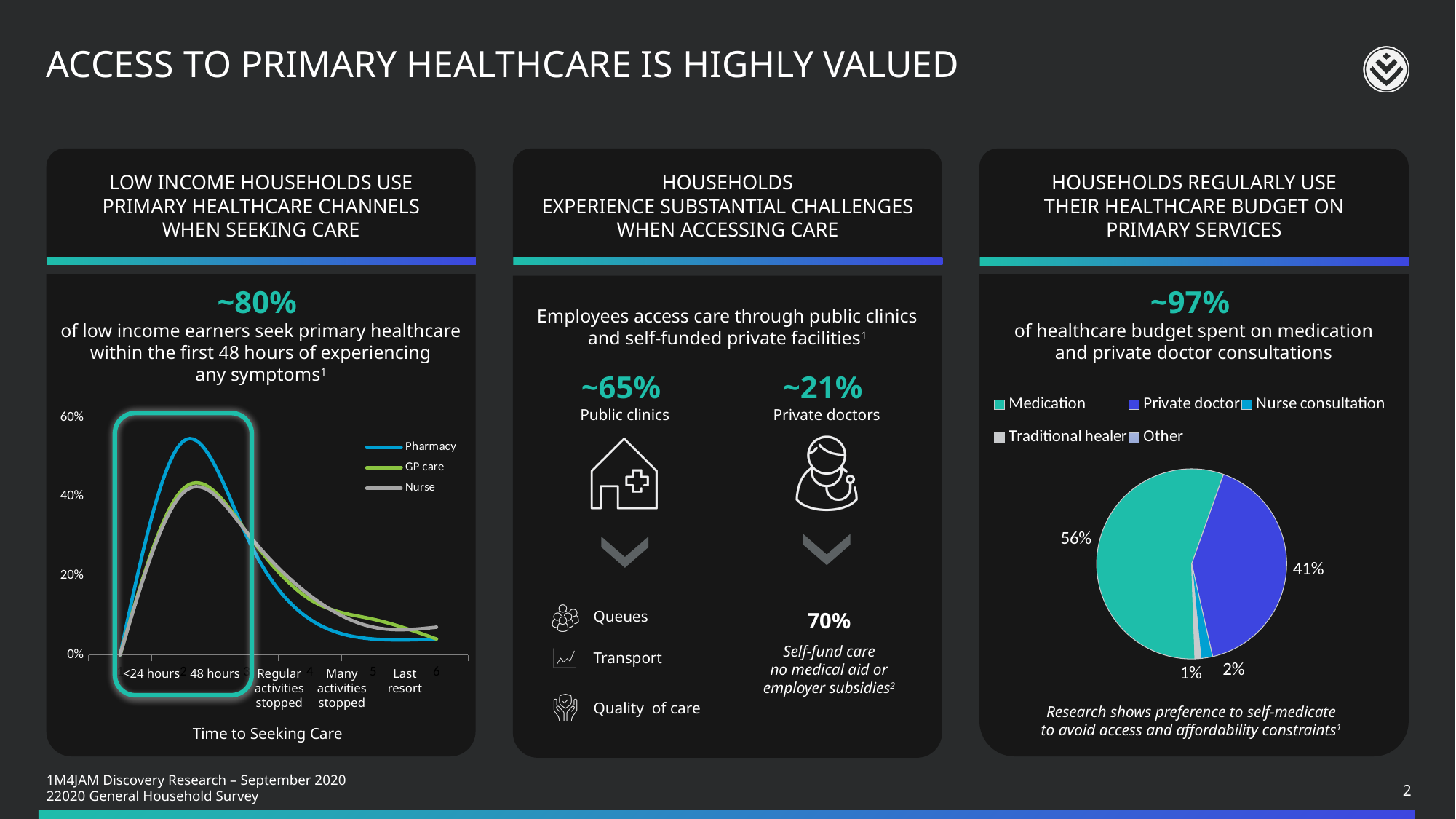
In the 'Time to Seeking Care' line chart, which series reaches the highest peak? Pharmacy In the 'Time to Seeking Care' line chart, is the Pharmacy value at 'Last resort' greater or less than 20%? less What kind of chart is the 'Time to Seeking Care' chart on the left panel? line chart In the pie chart on the right panel, what share is spent on Private doctor? 41% How many series does the legend of the 'Time to Seeking Care' line chart list? 3 In the pie chart on the right panel, what is the difference between the Medication and Private doctor shares? 15% How many categories does the legend of the pie chart on the right panel list? 5 In the pie chart on the right panel, what share of the healthcare budget is spent on Medication? 56% In the pie chart on the right panel, which category has the largest slice? Medication In the 'Time to Seeking Care' line chart, do the values rise or fall from '48 hours' to 'Last resort'? fall What kind of chart is shown in the right panel about healthcare budget? pie chart